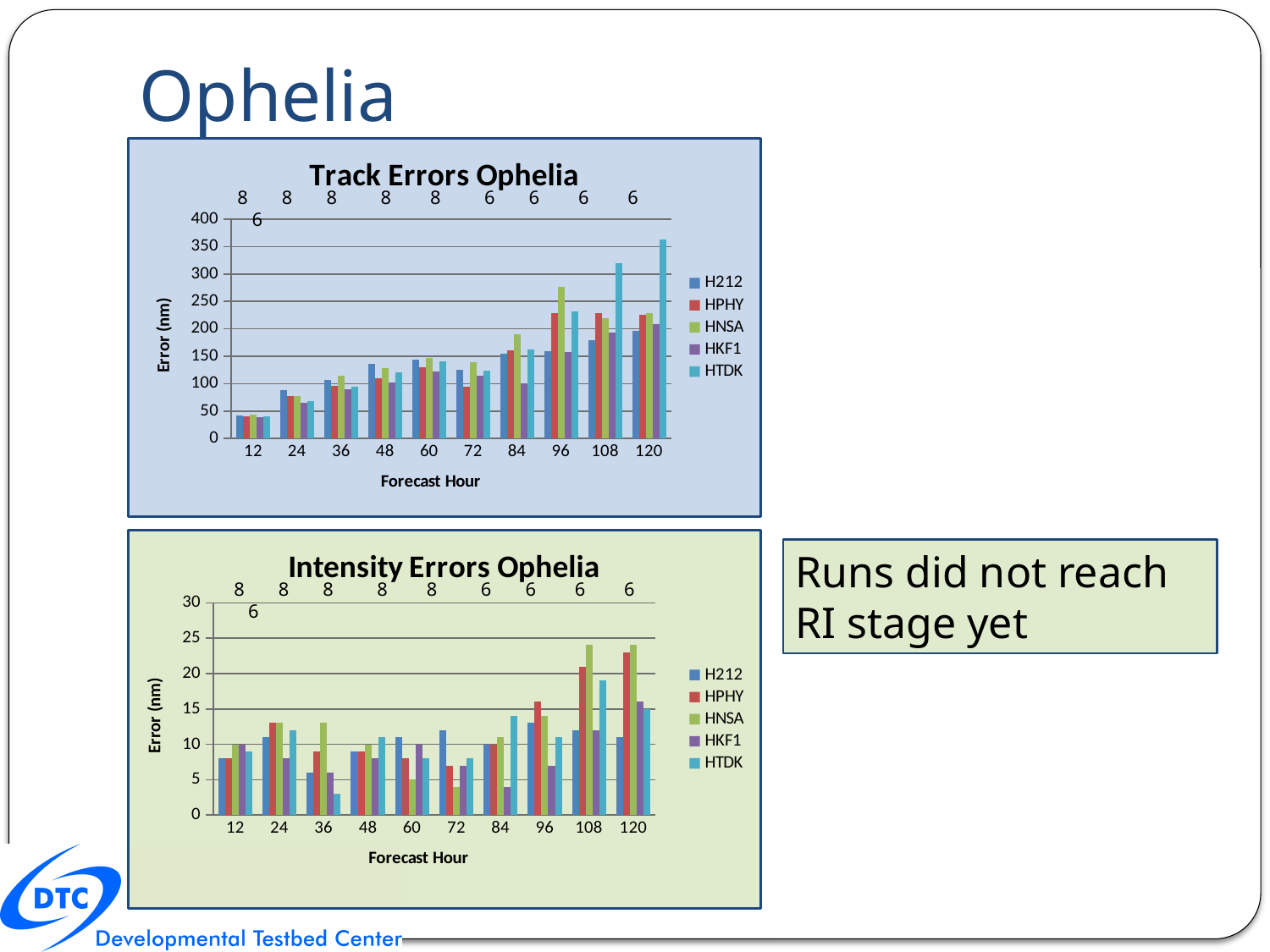
In the Intensity Errors Ophelia chart, is the HPHY value at forecast hour 108 greater or less than 20? greater In the Track Errors Ophelia chart, which series has the highest bar at forecast hour 120? HTDK In the Intensity Errors Ophelia chart, at forecast hour 108, which is larger: HNSA or HKF1? HNSA How many series does the legend of the Intensity Errors Ophelia chart list? 5 In the Track Errors Ophelia chart, is the HTDK value at forecast hour 120 greater or less than 350? greater What type of chart is the Track Errors Ophelia chart? bar chart In the Track Errors Ophelia chart, is the H212 value at forecast hour 12 greater or less than 50? less How many forecast hour categories are shown on the x axis of the Track Errors Ophelia chart? 10 In the Track Errors Ophelia chart, do the track errors generally rise or fall as forecast hour increases? rise In the Intensity Errors Ophelia chart, which series has the lowest bar at forecast hour 36? HTDK